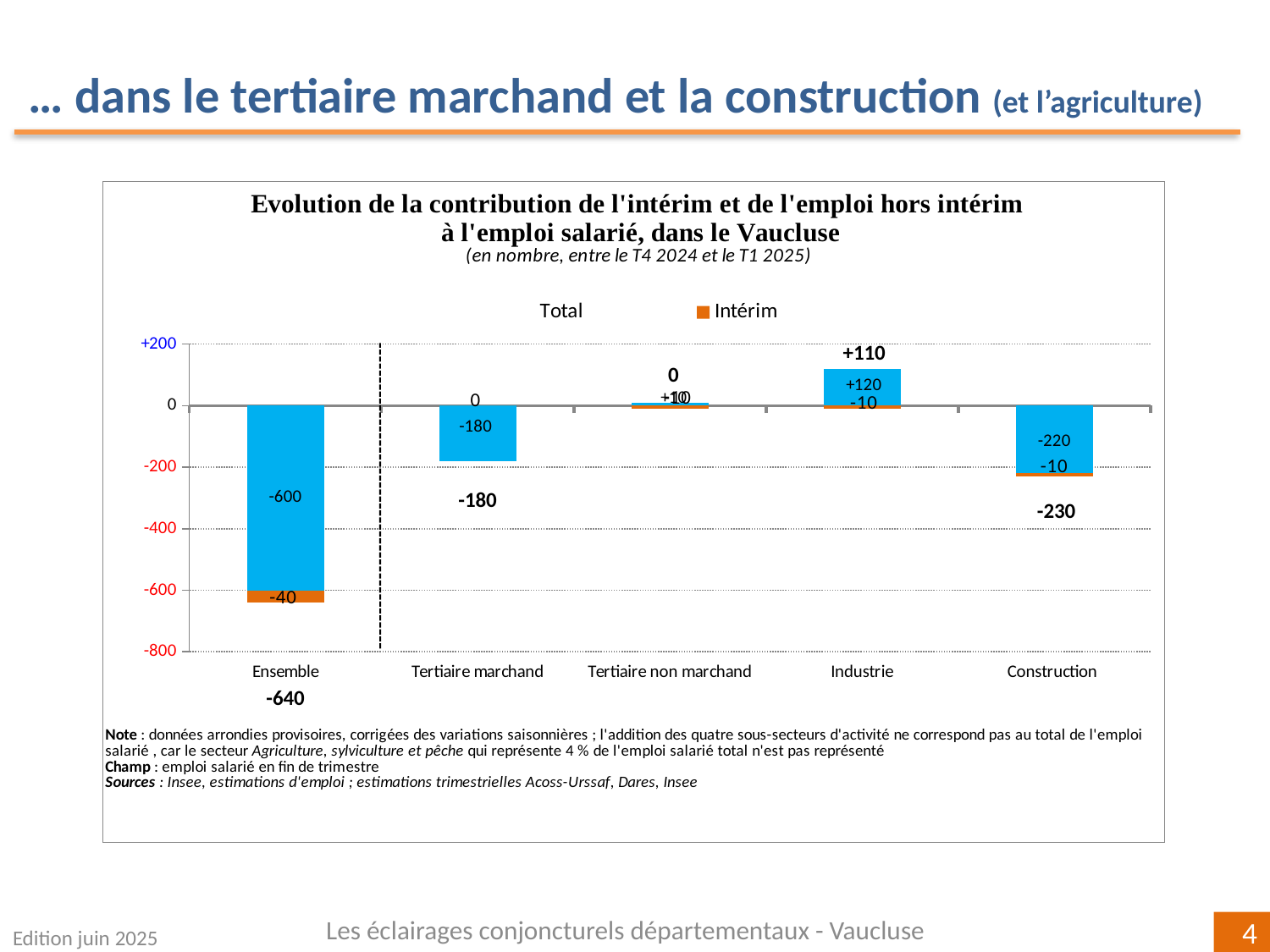
Which category has the lowest total value? Ensemble What is the Intérim value for Construction? -10 Which has the larger total value, Tertiaire marchand or Construction? Tertiaire marchand What is the total value shown for Construction? -230 What kind of chart is shown on the slide? bar chart How many series does the chart legend list? 2 What is the difference between the total for Ensemble (-640) and the total for Construction (-230)? 410 What is the value of the blue (non-Intérim) bar for Industrie? +120 How many categories are shown on the x axis of the chart? 5 What is the Intérim value for Ensemble? -40 Which category has the highest total value? Industrie What is the total value shown for Industrie? +110